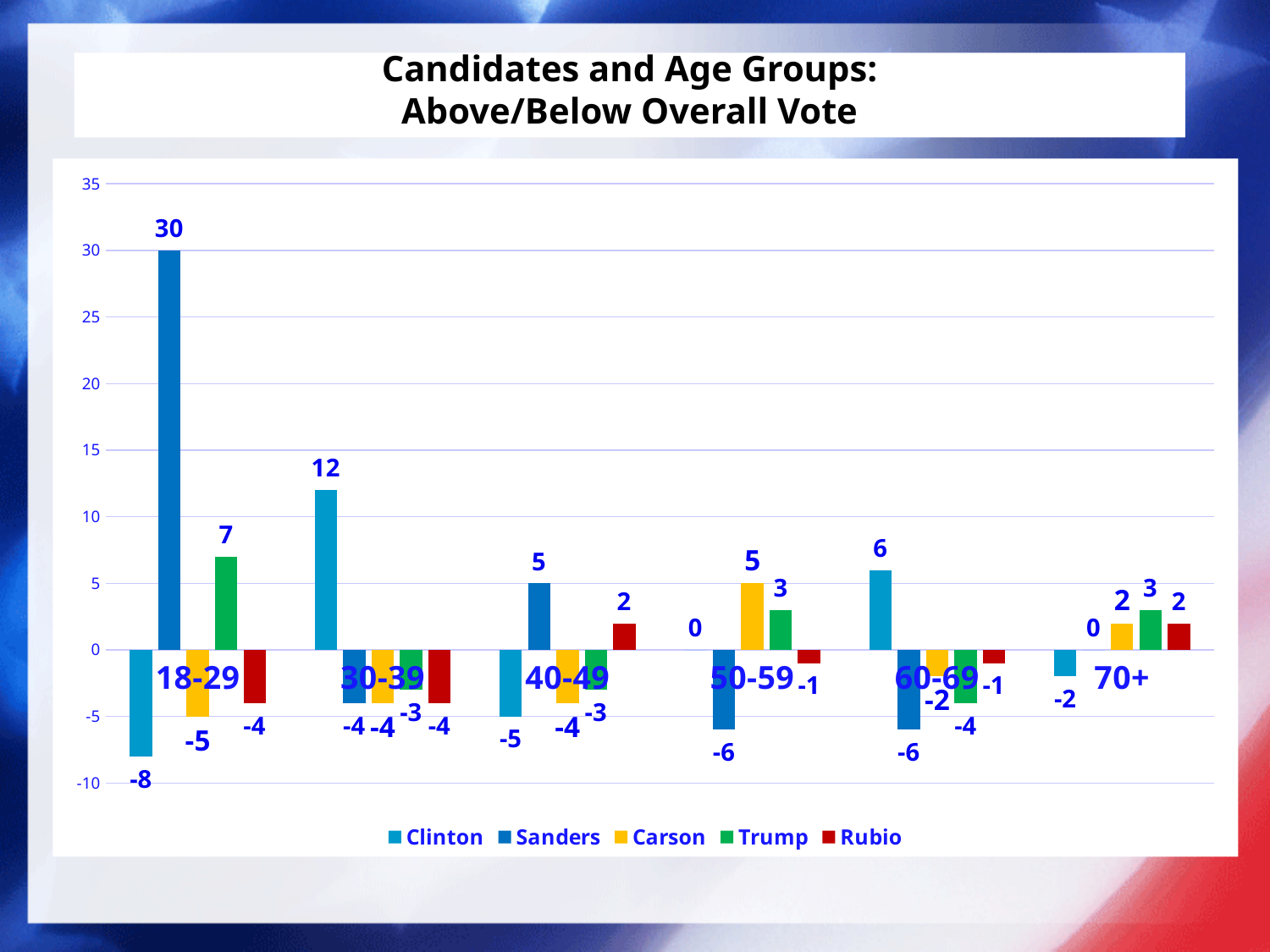
What is the value for Carson in the 50-59 age group? 5 What is the difference between the Sanders value and the Trump value in the 18-29 age group? 23 What is the value for Trump in the 18-29 age group? 7 What is the title of the chart? Candidates and Age Groups: Above/Below Overall Vote What kind of chart is shown on the slide? Bar chart Which candidate has the lowest value in the 18-29 age group? Clinton How many series does the legend list? 5 How many age groups are shown on the x axis? 6 What is the value for Clinton in the 30-39 age group? 12 Which is larger in the 40-49 age group, the value for Sanders or the value for Rubio? Sanders Which candidate has the highest value in the 60-69 age group? Clinton What is the value for Sanders in the 18-29 age group? 30